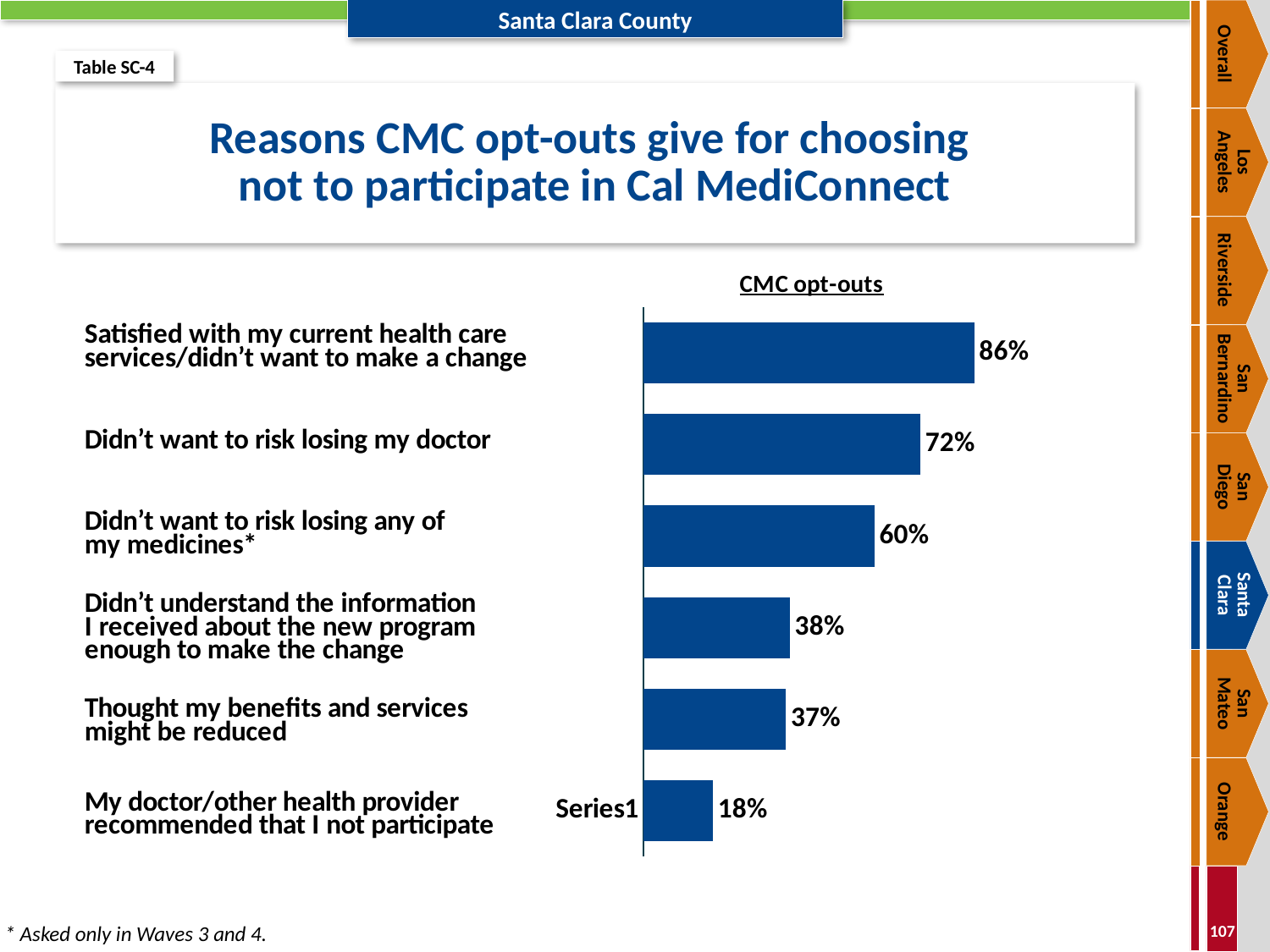
What kind of chart is shown on the slide? Bar chart What is the difference in percentage points between 'Satisfied with my current health care services/didn't want to make a change' and 'Didn't want to risk losing my doctor'? 14 percentage points Which reason has the lowest percentage? My doctor/other health provider recommended that I not participate What percentage of CMC opt-outs said their doctor/other health provider recommended that they not participate? 18% Which reason has the highest percentage? Satisfied with my current health care services/didn't want to make a change How many reasons are plotted in the chart? 6 What is the difference between 'Didn't want to risk losing my doctor' and 'Didn't want to risk losing any of my medicines'? 12 percentage points What is the title of the chart? Reasons CMC opt-outs give for choosing not to participate in Cal MediConnect What percentage of CMC opt-outs said they didn't want to risk losing their doctor? 72% What percentage of CMC opt-outs said they were satisfied with their current health care services/didn't want to make a change? 86% Which is larger: the value for 'Didn't understand the information I received about the new program enough to make the change' or 'Thought my benefits and services might be reduced'? Didn't understand the information I received about the new program enough to make the change What value is shown for 'Didn't want to risk losing any of my medicines'? 60%